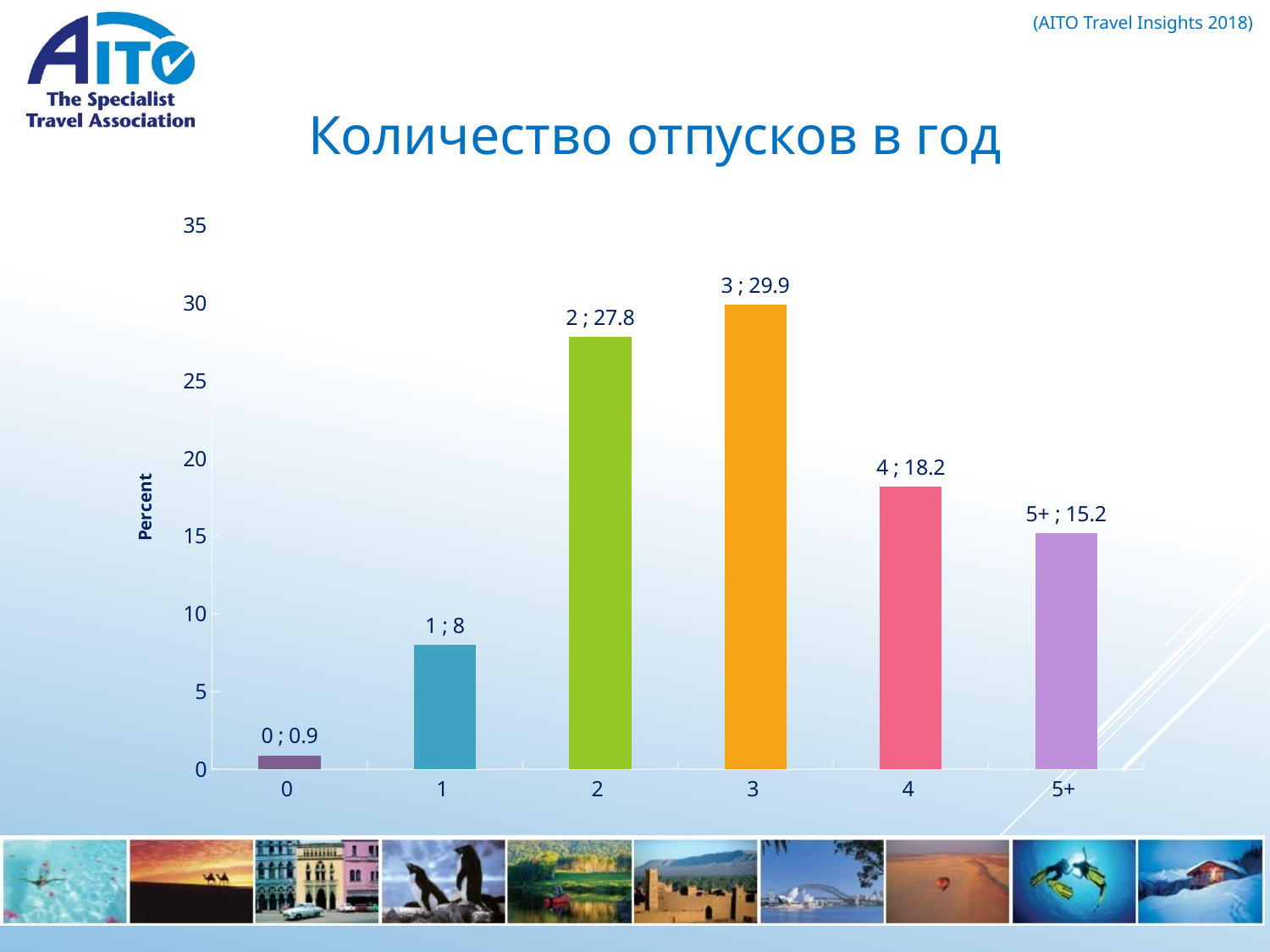
Is the value for category 2 greater or less than 25? greater Which category has the highest value? 3 Which category has the lowest value? 0 What is the difference between the values for categories 3 and 2? 2.1 What is the value for the category 0? 0.9 What is the value for the category 3? 29.9 What is the label of the y axis? Percent What is the value for the category 5+? 15.2 Which is larger, the value for category 1 or the value for category 4? 4 How many categories are shown on the x axis? 6 What is the difference between the values for categories 4 and 5+? 3 What kind of chart is shown on the slide? bar chart